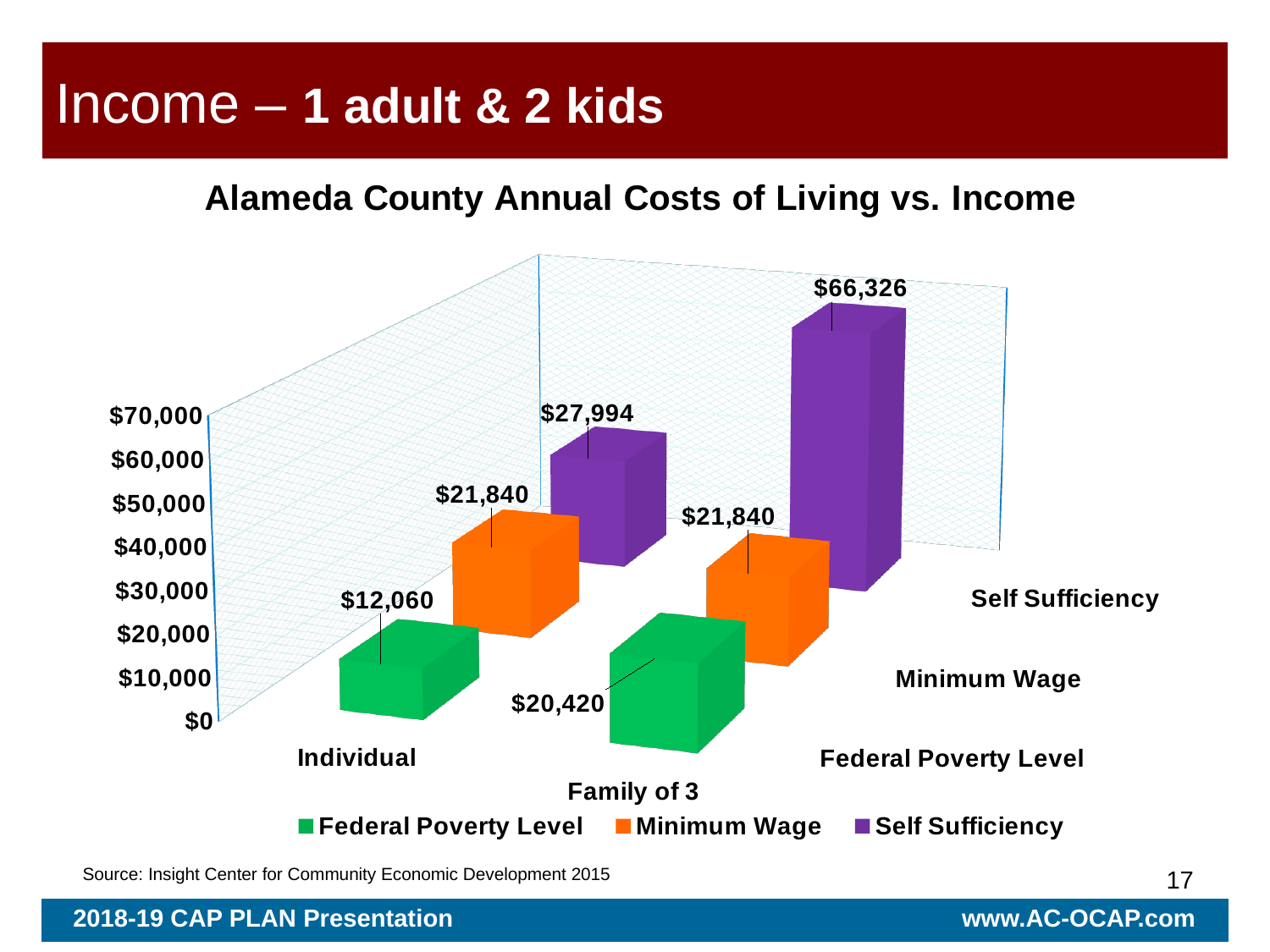
What is the Federal Poverty Level value for Individual? $12,060 What is the difference between the Minimum Wage and Federal Poverty Level values for Individual? $9,780 What is the Minimum Wage value for Family of 3? $21,840 What is the Self Sufficiency value for Individual? $27,994 What type of chart is shown on the slide? Bar chart What is the Self Sufficiency value for Family of 3? $66,326 How many series does the legend list? 3 Which is larger, the Federal Poverty Level value for Family of 3 or the Federal Poverty Level value for Individual? Family of 3 Which series has the lowest value for Individual? Federal Poverty Level Which series has the highest value for Family of 3? Self Sufficiency What is the difference between the Self Sufficiency values for Family of 3 and Individual? $38,332 What is the Federal Poverty Level value for Family of 3? $20,420